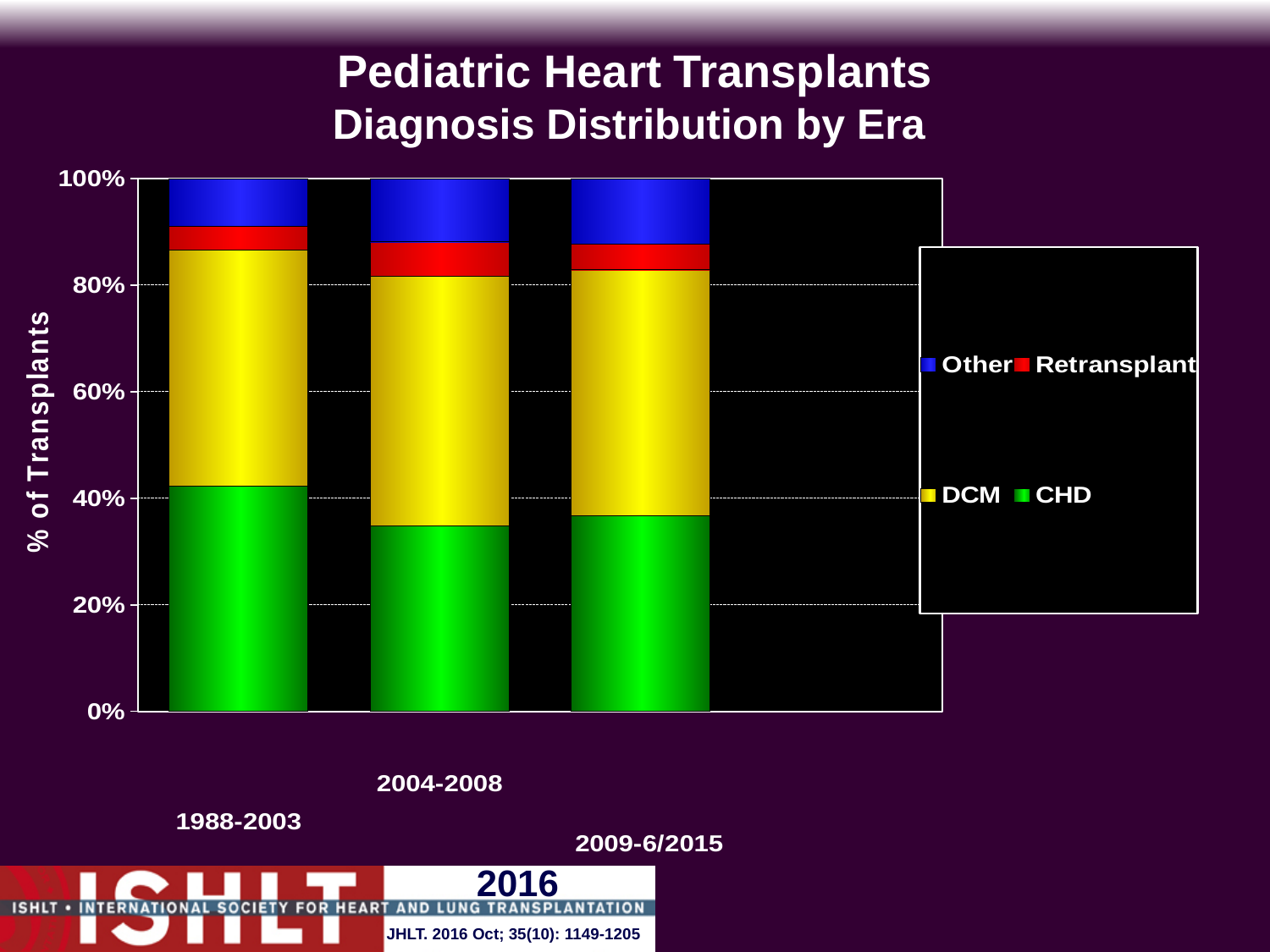
How many series does the legend list? 4 Is the top of the DCM segment for 2004-2008 above or below the 80% line? above What is the title of the chart? Pediatric Heart Transplants Diagnosis Distribution by Era What is the total height of each stacked bar? 100% What type of chart is shown on the slide? Stacked bar chart In which era is the CHD share the highest? 1988-2003 Is the CHD share for 2004-2008 greater or less than 40%? less Is the CHD share for 1988-2003 greater or less than 40%? greater In which era is the Other segment the smallest? 1988-2003 Which era has the larger CHD share, 1988-2003 or 2004-2008? 1988-2003 What colour represents CHD in the chart? Green How many eras (categories) are plotted on the x axis? 3